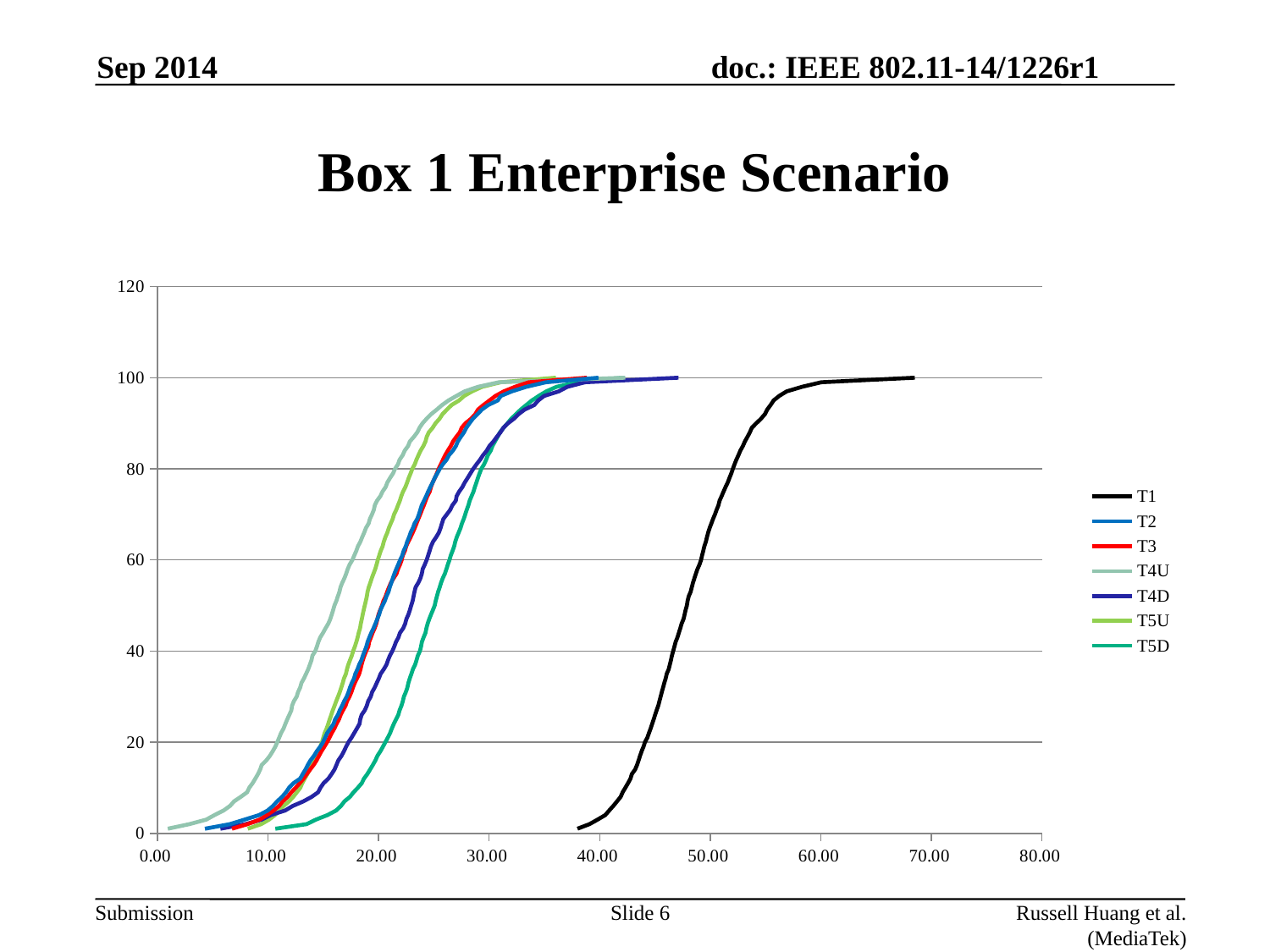
Do the values of each series rise or fall as the x axis increases? rise Which series reaches 100 at the largest x value? T1 Which series is drawn in black? T1 Which series lies furthest to the left on the chart? T4U At x = 50.00, which series has the larger value, T1 or T2? T2 Is the value of T1 at x = 40.00 greater or less than 20? less Is the value of T5D at x = 20.00 greater or less than 40? less What is the title of the chart? Box 1 Enterprise Scenario What kind of chart is shown on the slide? line chart How many series does the legend list? 7 Is the value of T1 at x = 60.00 greater or less than 80? greater